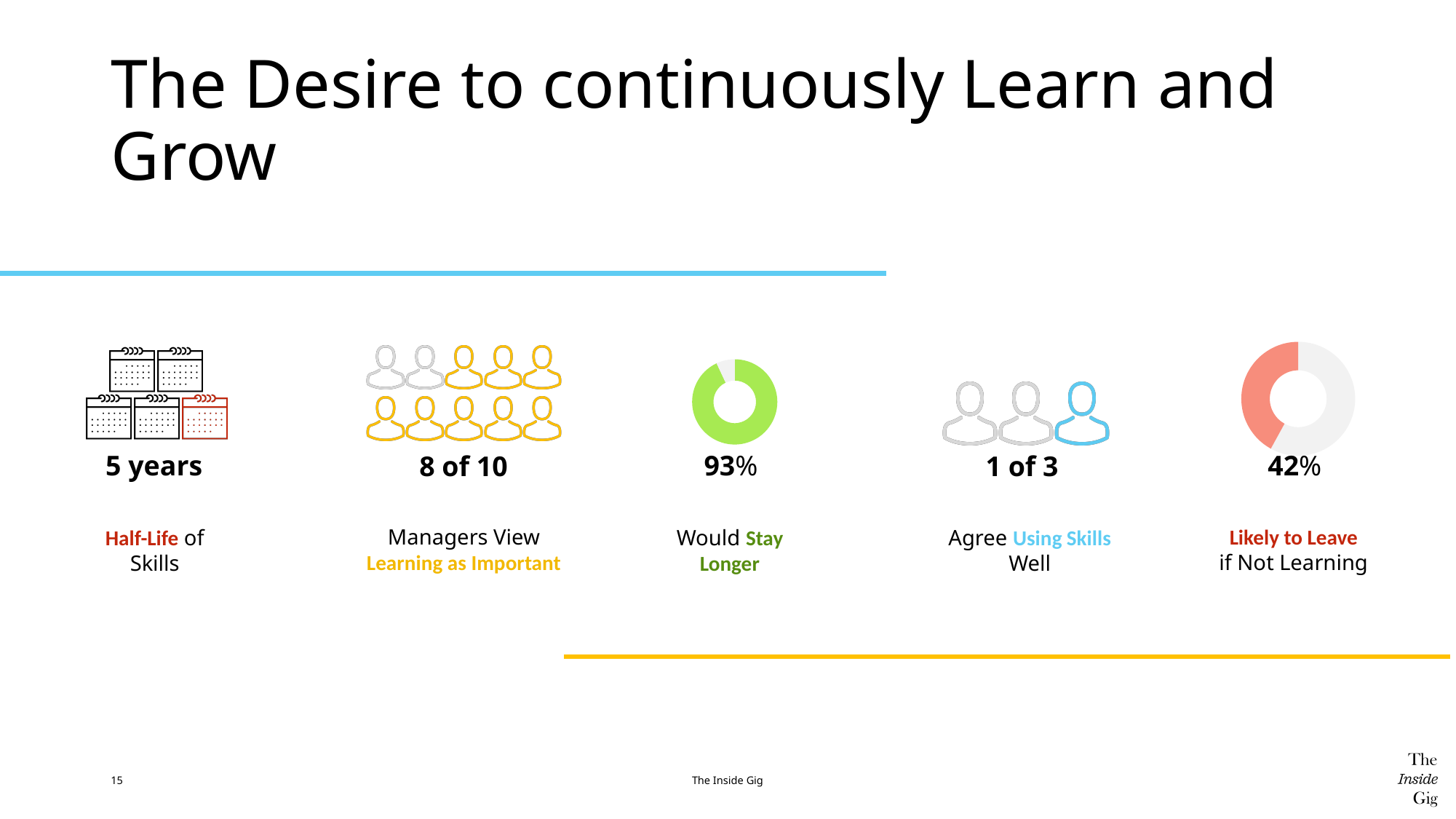
Which donut chart shows the larger filled share, "Would Stay Longer" or "Likely to Leave if Not Learning"? Would Stay Longer What percentage does the red donut chart labelled "Likely to Leave if Not Learning" show? 42% How many of the person icons in the "Managers View Learning as Important" pictogram are highlighted in yellow? 8 How many person icons are shown in the "Managers View Learning as Important" pictogram? 10 What is the difference between the "Would Stay Longer" percentage and the "Likely to Leave if Not Learning" percentage? 51 percentage points In the "Likely to Leave if Not Learning" donut chart, is the filled share greater or less than 50%? less What colour is the filled segment of the "Likely to Leave if Not Learning" donut chart? Red What kind of chart is used to show the 93% "Would Stay Longer" figure? Donut (pie) chart In the "Would Stay Longer" donut chart, what share of the ring is left unfilled (grey)? 7% How many calendar icons are shown in the "Half-Life of Skills" pictogram? 5 How many person icons are shown in the "Agree Using Skills Well" pictogram? 3 What percentage does the green donut chart labelled "Would Stay Longer" show? 93%